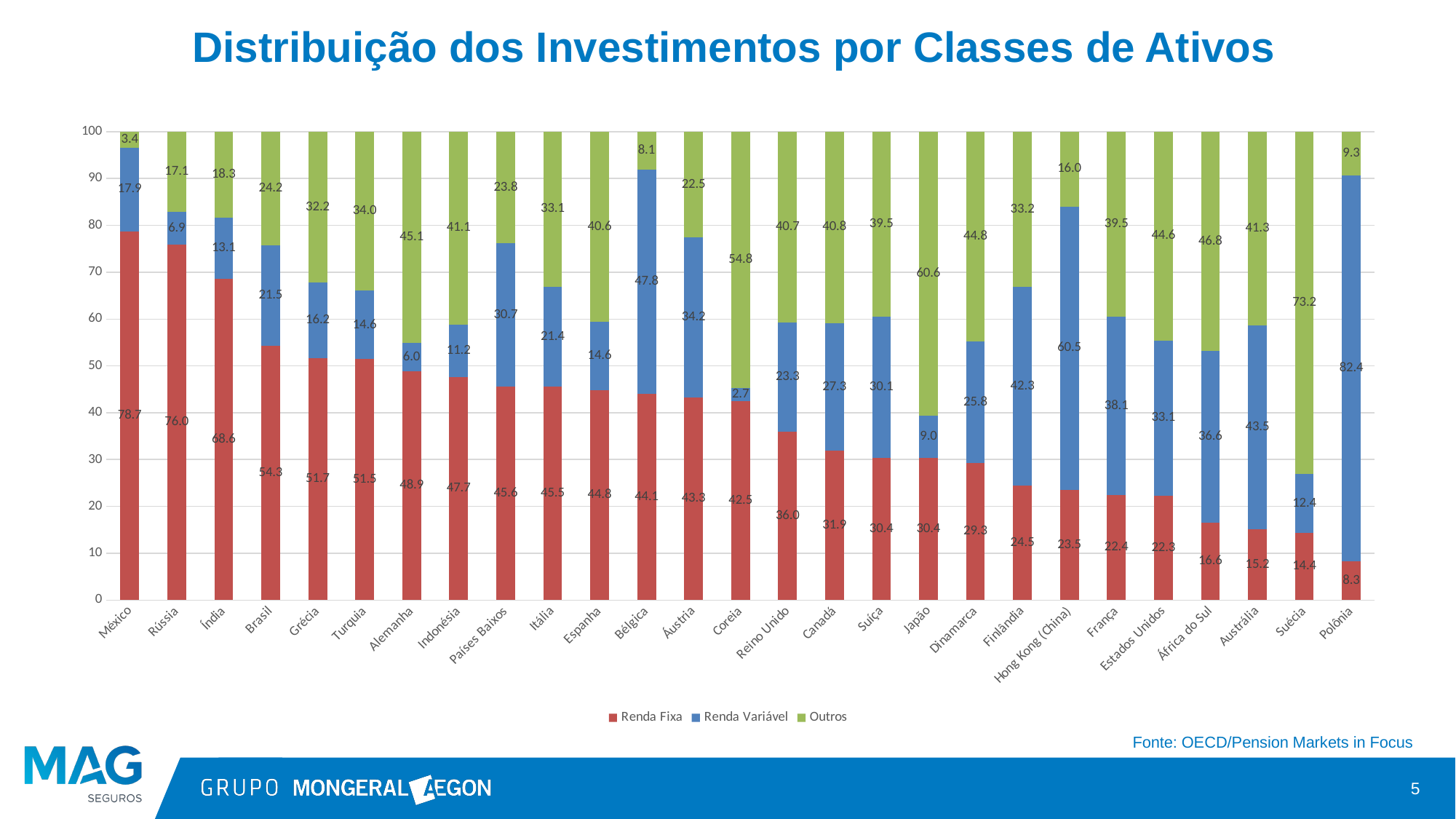
Does the Renda Fixa value rise or fall from left to right across the countries? fall Which has a larger Renda Variável value, Finlândia or Austrália? Austrália How many series does the legend list? 3 What is the difference between the Outros and Renda Variável values for Brasil? 2.7 Which country has the lowest Renda Fixa value? Polônia What is the Outros value for Japão? 60.6 How many countries are shown on the x axis? 27 Which country has the highest Outros value? Suécia What is the Renda Variável value for Hong Kong (China)? 60.5 Which country has the lowest Renda Variável value? Coreia What is the Renda Fixa value for Brasil? 54.3 Which country has the highest Renda Fixa value? México